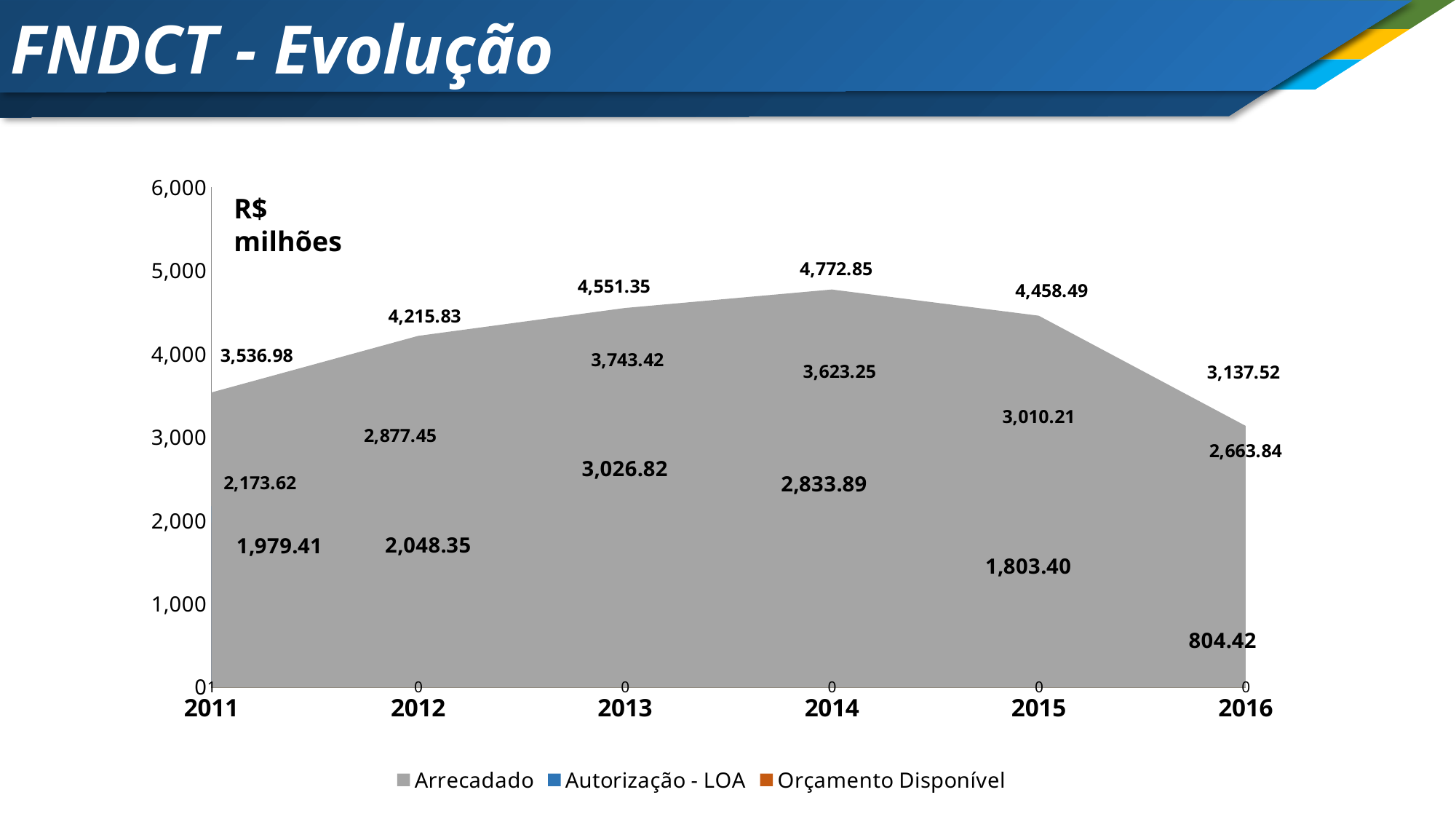
What is the Arrecadado value for 2016? 3,137.52 In which year is the Arrecadado value highest? 2014 What is the Arrecadado value for 2014? 4,772.85 Which year has the larger Arrecadado value, 2012 or 2015? 2015 How many years are shown on the x axis? 6 Does the Arrecadado value rise or fall from 2011 to 2014? rise In which year is the Arrecadado value lowest? 2016 What is the difference between the Arrecadado values for 2014 and 2013? 221.50 What unit is indicated in the top-left corner of the chart? R$ milhões What kind of chart is shown on the slide? area chart How many series does the legend list? 3 Is the Arrecadado value for 2011 greater or less than 4,000? less